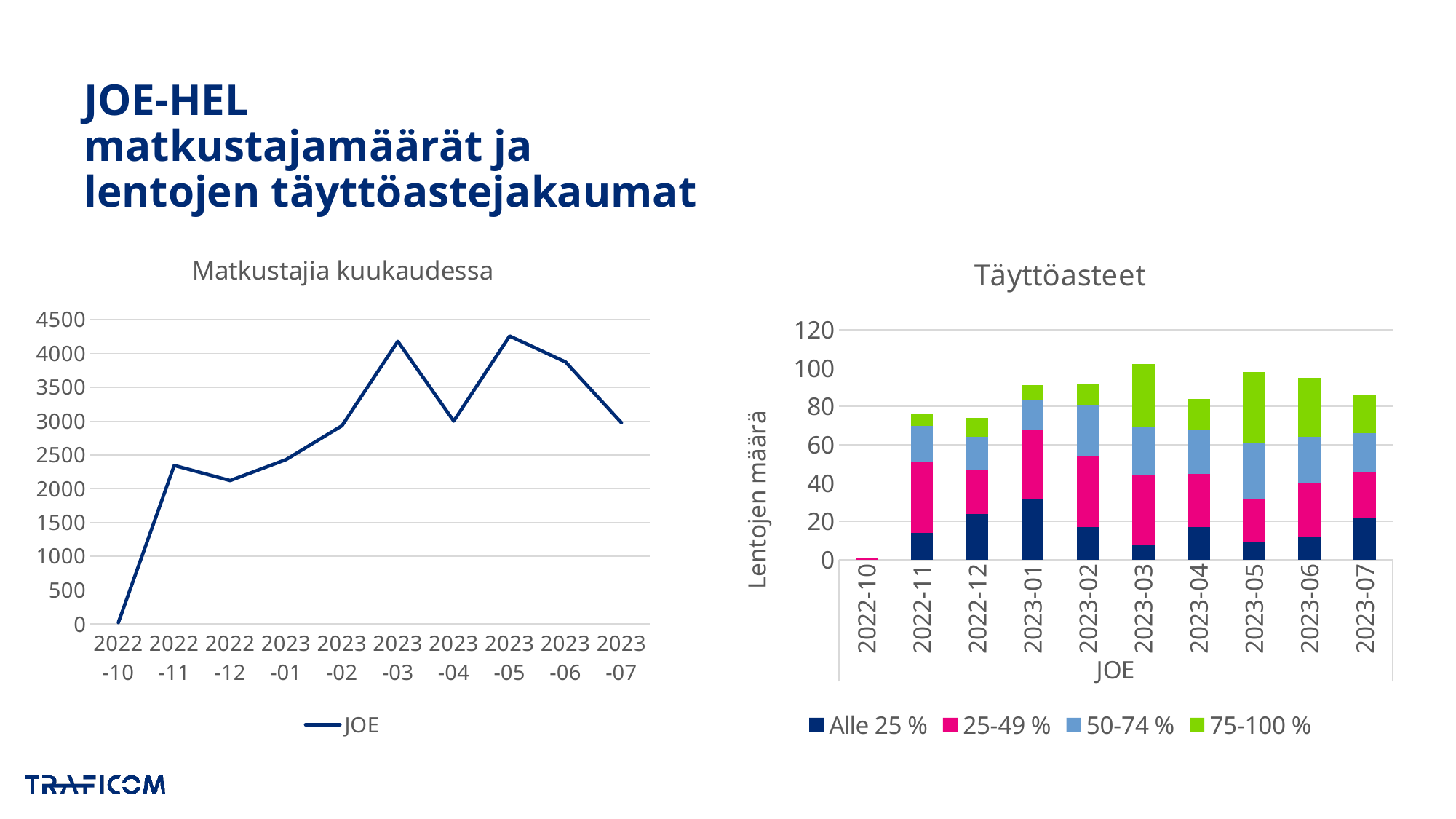
In the 'Täyttöasteet' chart, how many series does the legend list? 4 In the 'Täyttöasteet' chart, is the total bar height for 2023-05 greater or less than 80? greater In the 'Täyttöasteet' chart, which month has the shortest stacked bar? 2022-10 In the 'Matkustajia kuukaudessa' chart, is the value for 2023-06 greater or less than 3500? greater In the 'Matkustajia kuukaudessa' chart, which month has the lowest value? 2022-10 In the 'Matkustajia kuukaudessa' chart, is the value for 2023-03 greater or less than 4000? greater In the 'Täyttöasteet' chart, what is the label of the vertical axis? Lentojen määrä In the 'Matkustajia kuukaudessa' chart, how many months are plotted on the x axis? 10 In the 'Täyttöasteet' chart, which month has the tallest stacked bar? 2023-03 In the 'Matkustajia kuukaudessa' chart, does the value rise or fall from 2023-05 to 2023-07? fall What kind of chart is the 'Täyttöasteet' chart on the right? stacked bar chart What kind of chart is the 'Matkustajia kuukaudessa' chart on the left? line chart